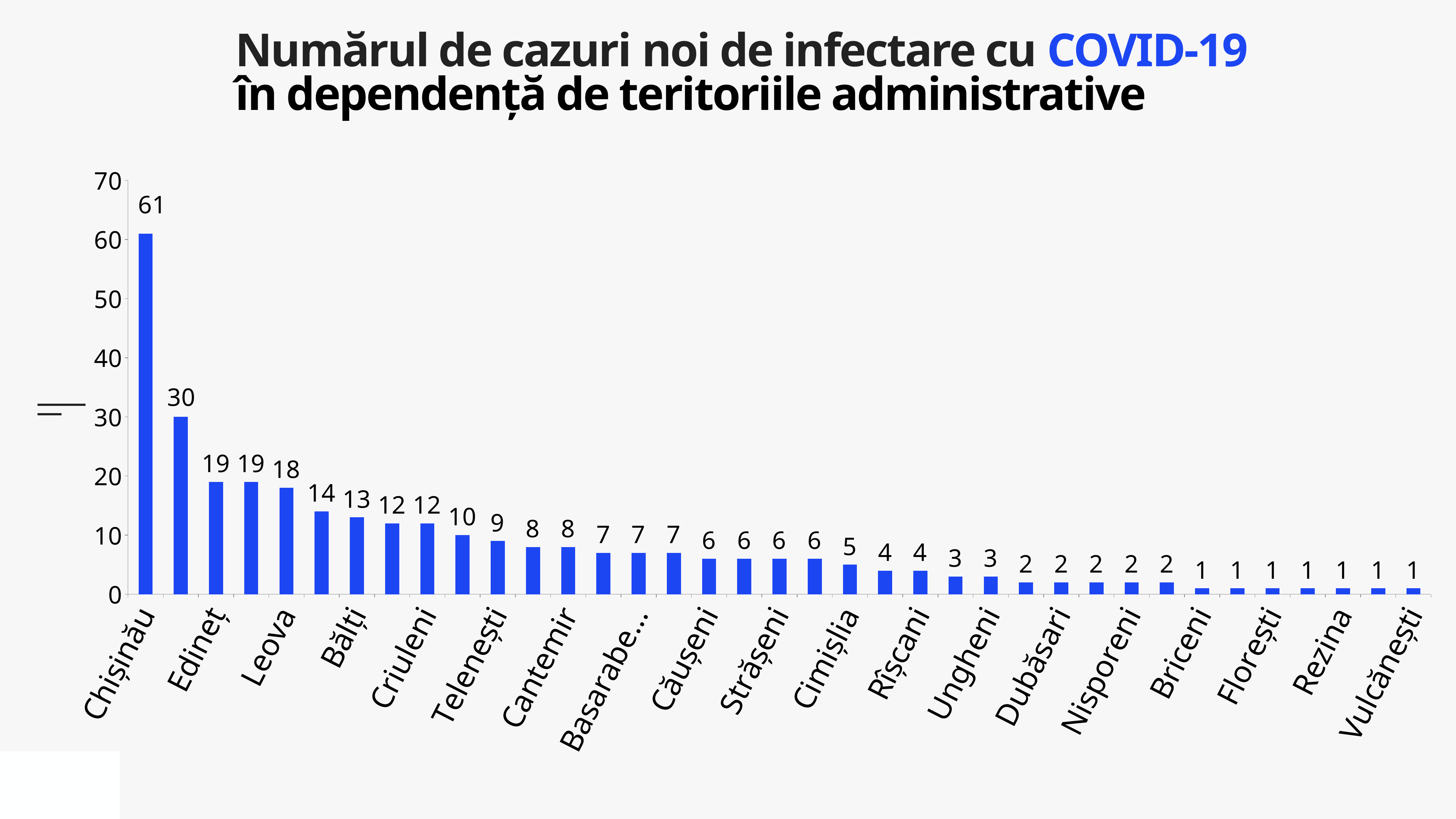
What is the value for Chișinău? 61 What is the difference between the values for Chișinău and Edineț? 42 What is the value for Bălți? 13 Which has a larger value, Leova or Bălți? Leova Is the value for Chișinău greater or less than 50? greater What is the value for Criuleni? 12 What is the value for Leova? 18 Do the values rise or fall from left to right along the x axis? fall What kind of chart is shown on the slide? bar chart What is the value for Edineț? 19 Which territory has the highest number of new cases? Chișinău What is the value for Cimișlia? 5